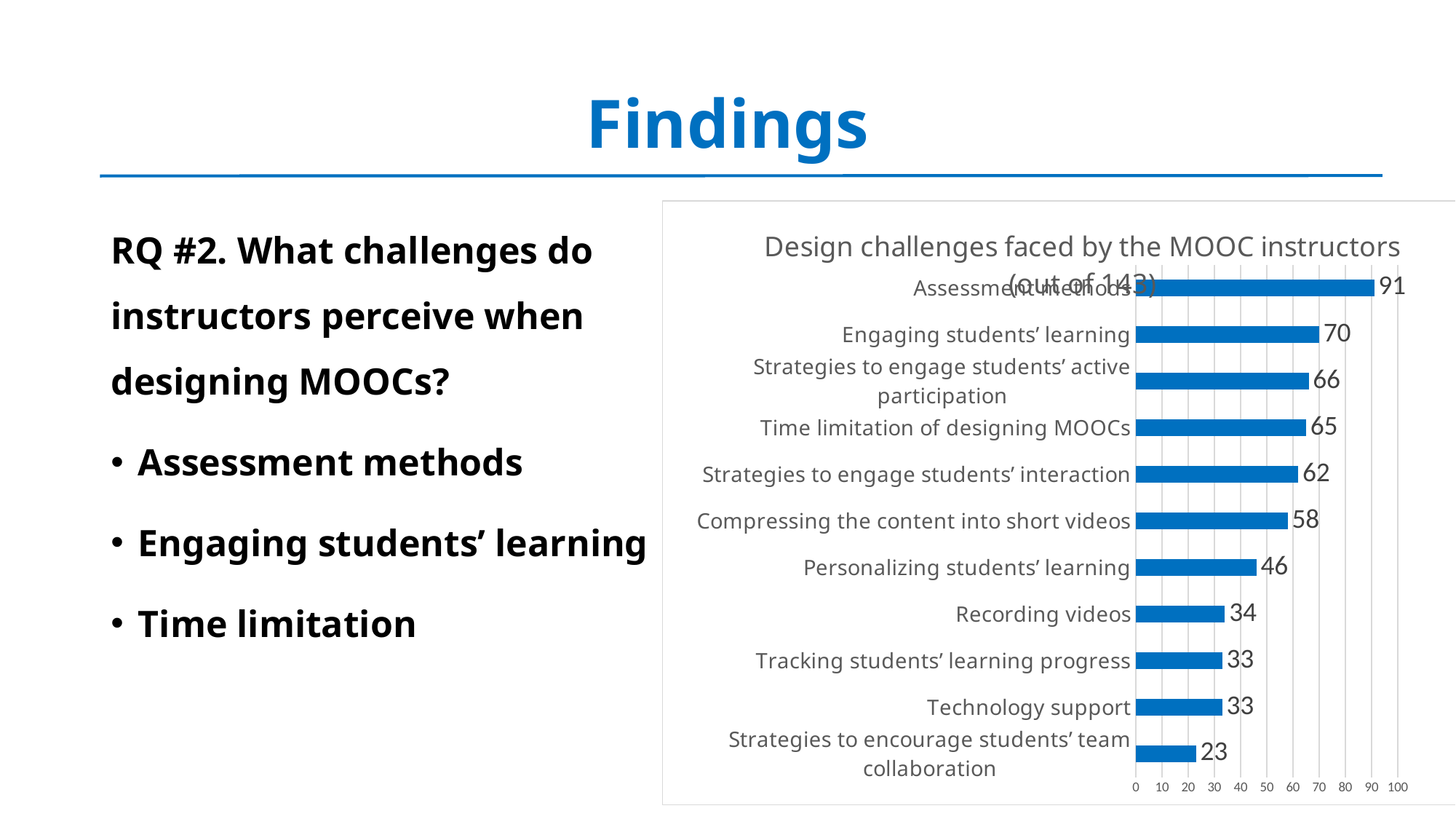
What is the value for Personalizing students' learning? 46 What is the difference between the values for Assessment methods and Engaging students' learning? 21 What is the title of the chart? Design challenges faced by the MOOC instructors (out of 143) What is the value for Strategies to encourage students' team collaboration? 23 How many design challenges are plotted in the chart? 11 What is the value for Engaging students' learning? 70 Which design challenge has the lowest value? Strategies to encourage students' team collaboration What is the value for Time limitation of designing MOOCs? 65 Which is larger, the value for Compressing the content into short videos or the value for Recording videos? Compressing the content into short videos Which design challenge has the highest value? Assessment methods What is the difference between the values for Strategies to engage students' interaction and Tracking students' learning progress? 29 What kind of chart is shown on the slide? Bar chart